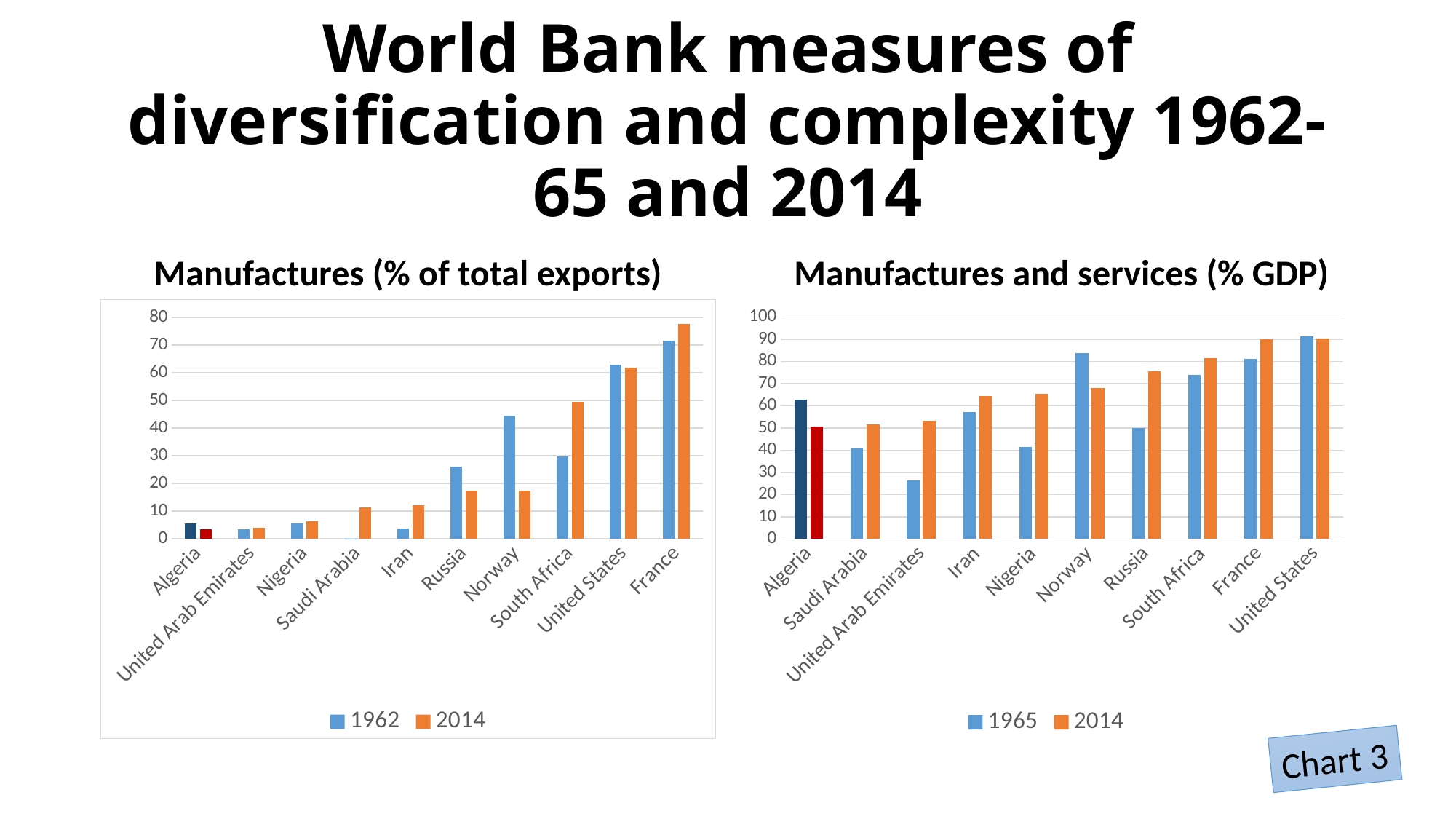
On the 'Manufactures (% of total exports)' chart, which country has the highest 2014 value? France On the 'Manufactures and services (% GDP)' chart, is the 1965 value for Norway greater or less than 80? greater On the 'Manufactures (% of total exports)' chart, is Norway's value larger in 1962 or in 2014? 1962 On the 'Manufactures (% of total exports)' chart, is the 1962 value for Russia greater or less than 20? greater On the 'Manufactures and services (% GDP)' chart, which country has the lowest 1965 value? United Arab Emirates On the 'Manufactures and services (% GDP)' chart, is Algeria's value larger in 1965 or in 2014? 1965 How many series does the legend of the 'Manufactures and services (% GDP)' chart list? 2 On the 'Manufactures and services (% GDP)' chart, is the 1965 value for United Arab Emirates greater or less than 30? less What are the two series listed in the legend of the 'Manufactures (% of total exports)' chart? 1962 and 2014 What kind of chart is the 'Manufactures (% of total exports)' chart? bar chart How many countries are shown on the 'Manufactures (% of total exports)' chart? 10 On the 'Manufactures (% of total exports)' chart, which country has the lowest 1962 value? Saudi Arabia